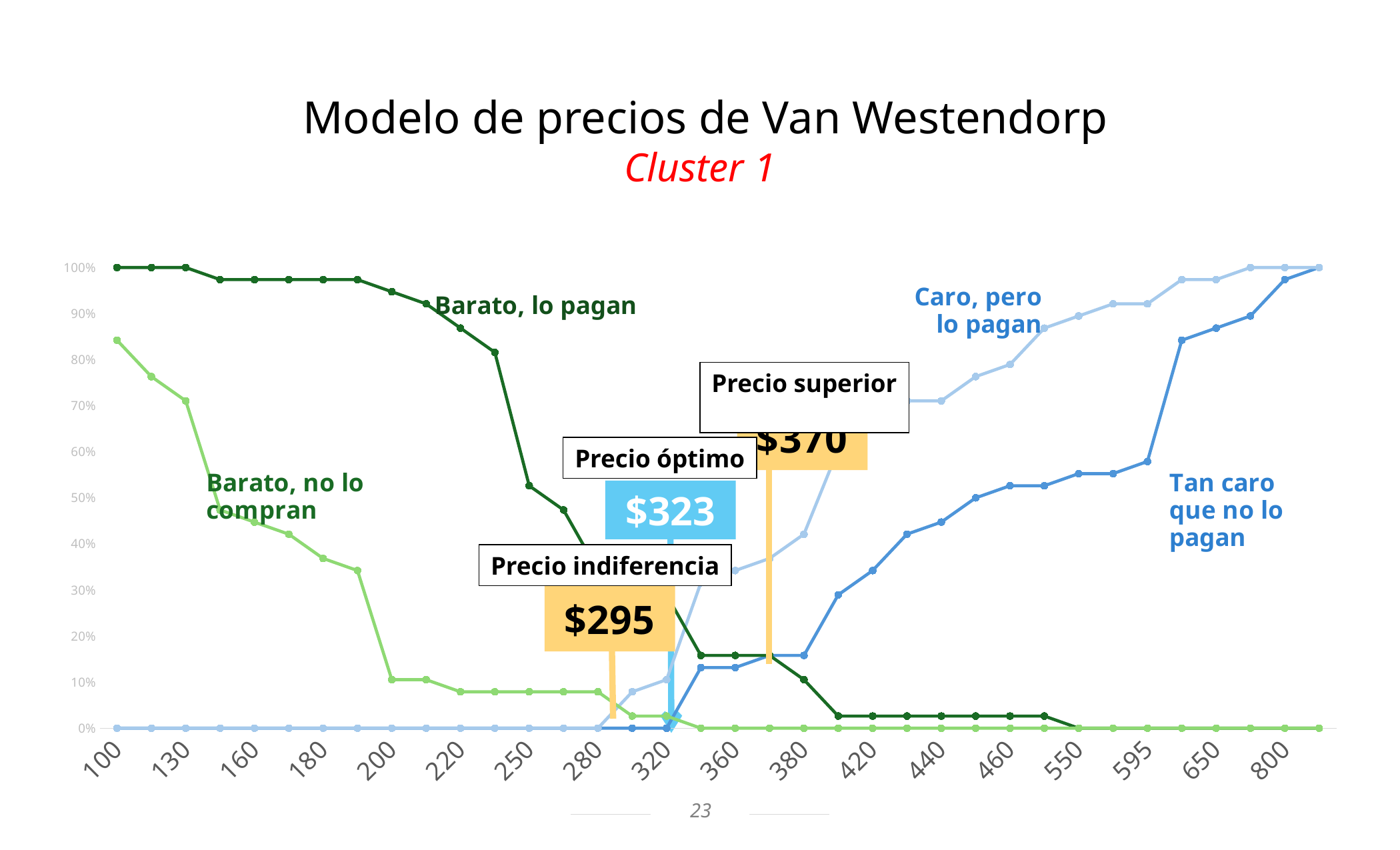
What is the difference between the 'Precio óptimo' and the 'Precio indiferencia'? $28 At price 800, which line is higher: 'Tan caro que no lo pagan' or 'Barato, no lo compran'? Tan caro que no lo pagan Does the 'Barato, lo pagan' line rise or fall as price increases along the x axis? falls Is the value of 'Barato, no lo compran' at price 100 greater or less than 70%? greater What is the value shown for 'Precio óptimo'? $323 Does the 'Tan caro que no lo pagan' line rise or fall as price increases along the x axis? rises What kind of chart is shown on the slide? line chart What is the difference between the 'Precio superior' and the 'Precio indiferencia'? $75 What is the value of 'Barato, lo pagan' at price 100? 100% How many labelled lines are plotted on the chart? 4 What is the value shown for 'Precio superior'? $370 What is the value shown for 'Precio indiferencia'? $295